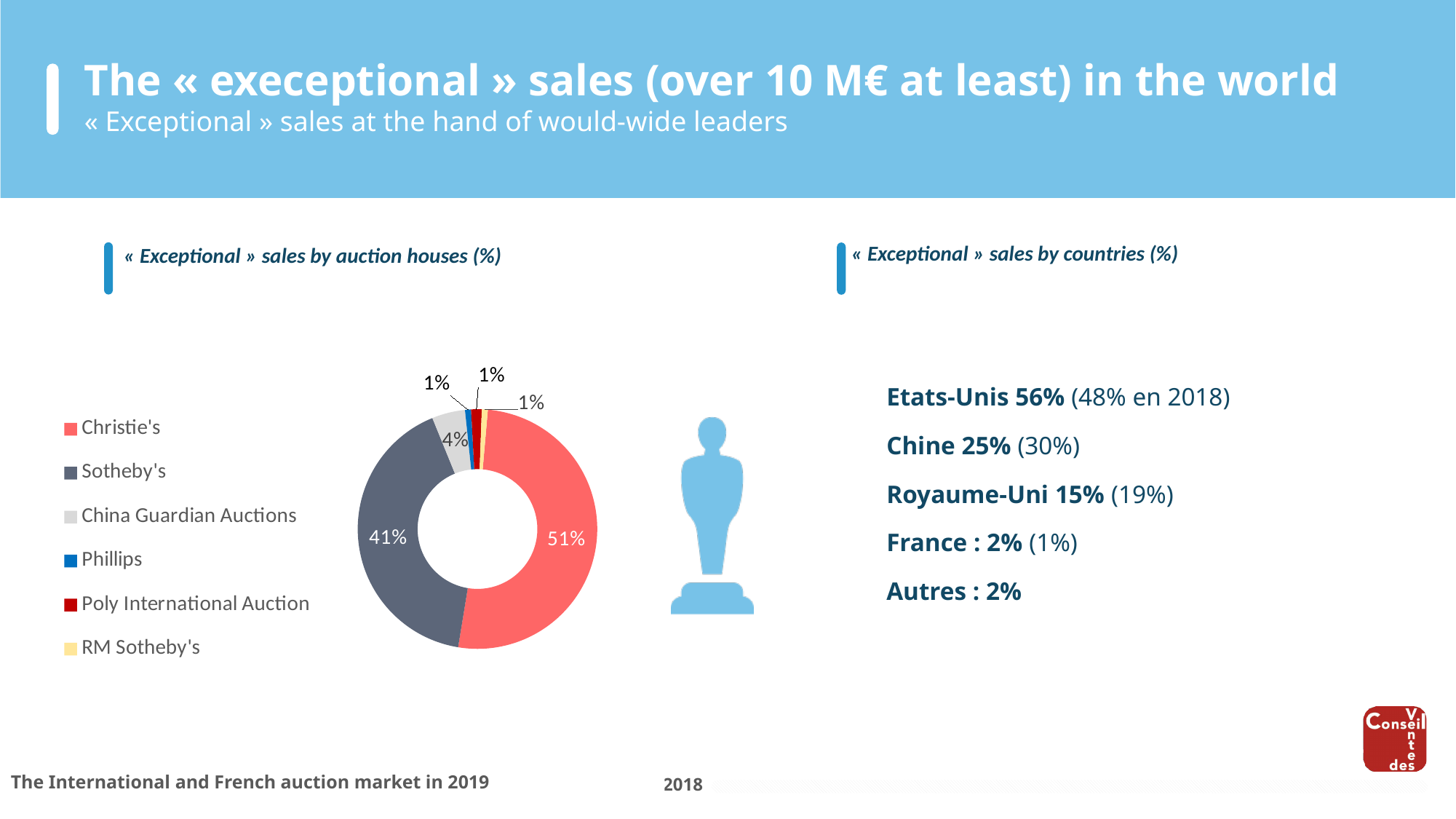
How many auction houses are listed in the chart legend? 6 What is the combined share of Christie's and Sotheby's? 92% What type of chart is used to show « exceptional » sales by auction houses? Pie chart (donut) Which colour represents Christie's in the chart? Red What is the difference in percentage points between Christie's and Sotheby's shares? 10 What is the value shown for China Guardian Auctions? 4% What is the title of the chart on the left of the slide? « Exceptional » sales by auction houses (%) What percentage of « exceptional » sales is attributed to Sotheby's? 41% What percentage is shown for Phillips in the chart? 1% Which auction house has the largest share of « exceptional » sales? Christie's Which has a larger share, Sotheby's or China Guardian Auctions? Sotheby's What share of « exceptional » sales does Christie's hold in the pie chart? 51%